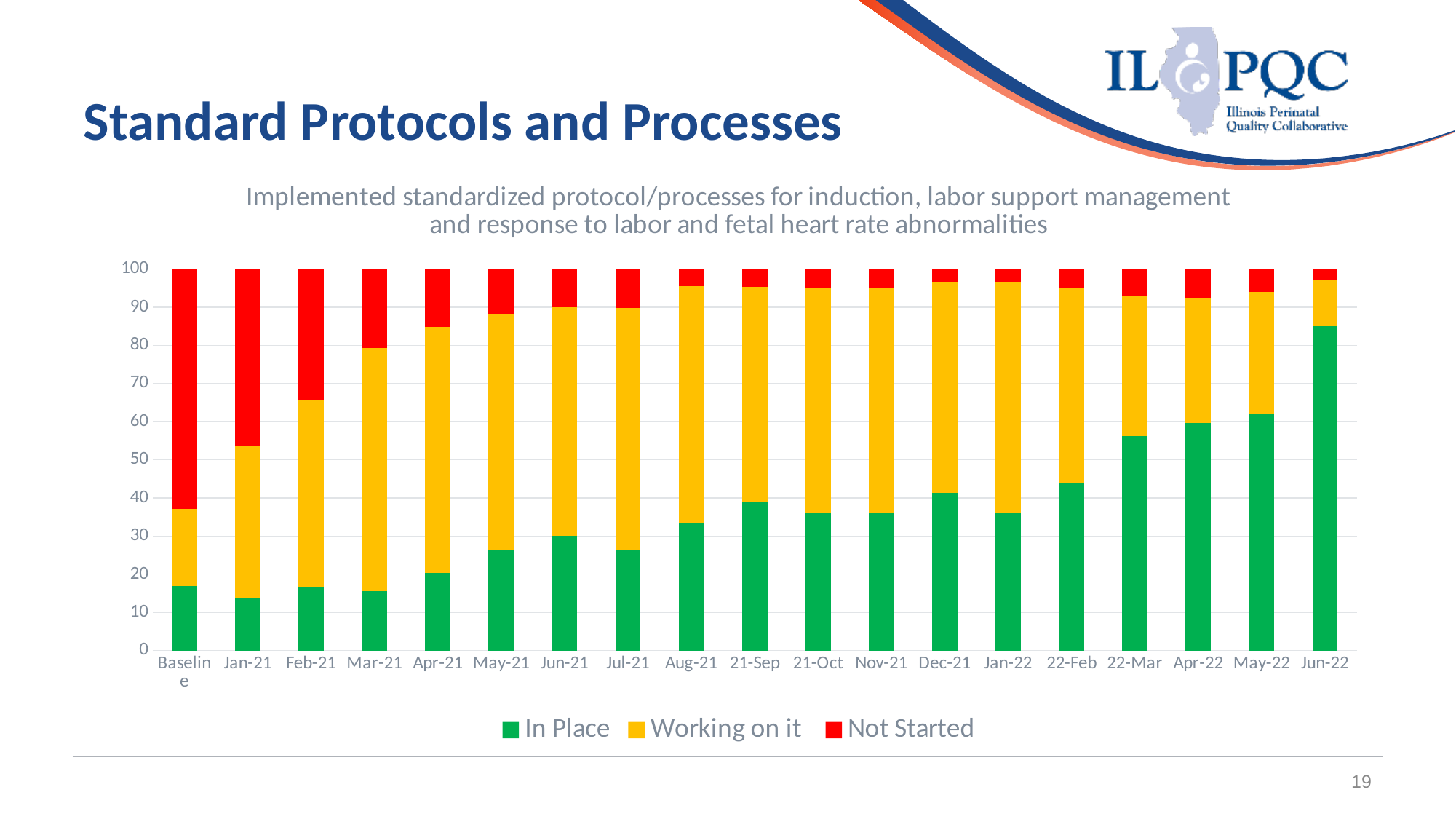
How many series does the legend list? 3 Which is larger, the 'In Place' value for Jun-22 or for Baseline? Jun-22 Which category has the largest 'Not Started' segment? Baseline What kind of chart is shown on the slide? Stacked bar chart Is the 'In Place' value for Jan-21 greater or less than 20? less Is the 'In Place' value for Jun-22 greater or less than 80? greater How many time-period categories are shown along the x axis? 19 Which colour represents the 'Not Started' series? Red Which category has the highest 'In Place' value? Jun-22 Does the 'In Place' series generally rise or fall from Baseline to Jun-22? Rise Is the 'In Place' value for 22-Mar greater or less than 50? greater Which category has the lowest 'In Place' value? Jan-21